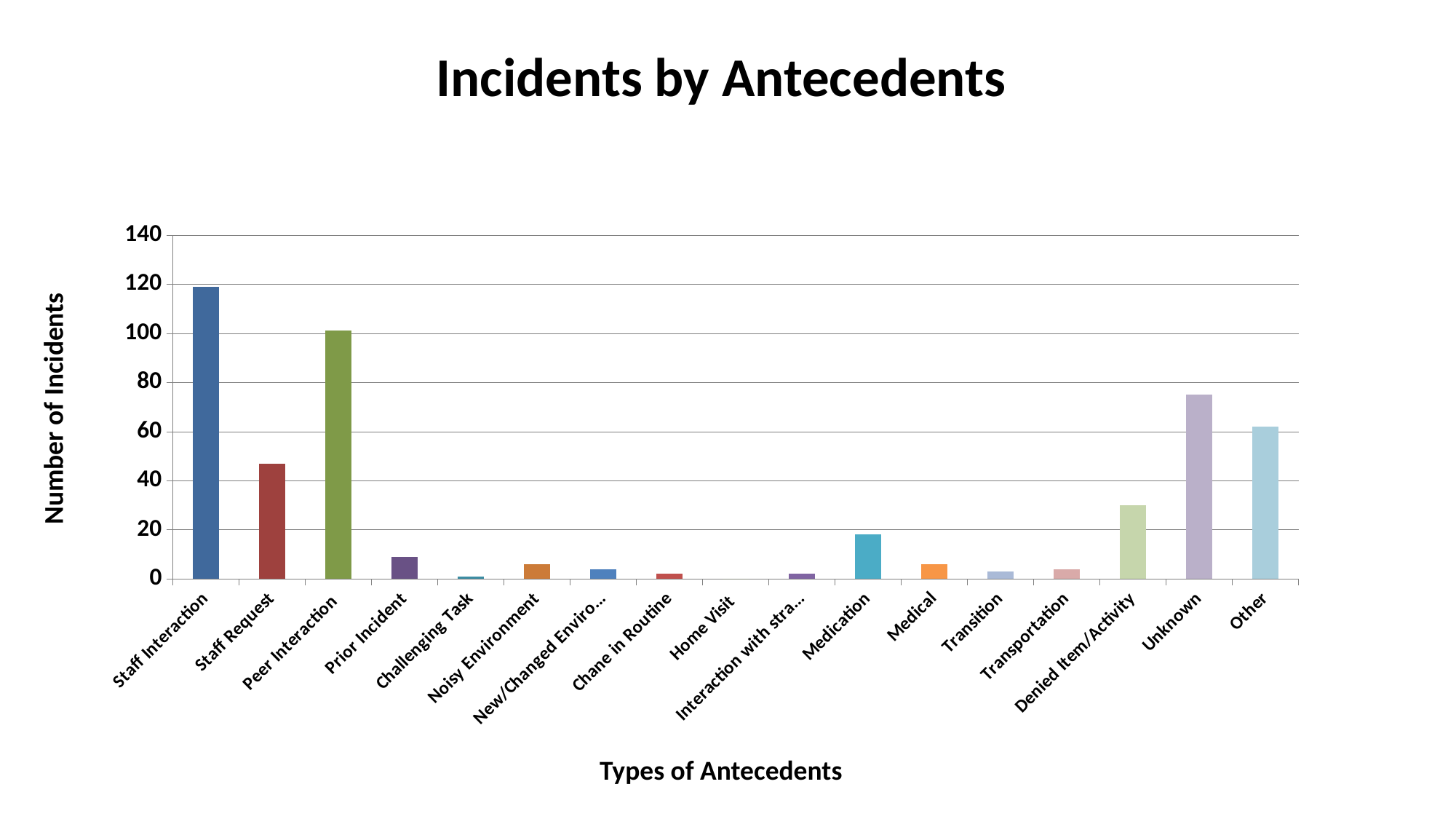
Is the value for Denied Item/Activity greater or less than 20? greater Is the value for Prior Incident greater or less than 20? less Which has more incidents, Staff Interaction or Peer Interaction? Staff Interaction What kind of chart is shown on the slide? bar chart What is the title of the chart? Incidents by Antecedents Which has more incidents, Unknown or Other? Unknown Is the value for Staff Interaction greater or less than 100? greater Which antecedent has the highest number of incidents? Staff Interaction Which antecedent has the lowest number of incidents? Home Visit How many antecedent categories are plotted on the chart? 17 What is the label on the vertical axis of the chart? Number of Incidents